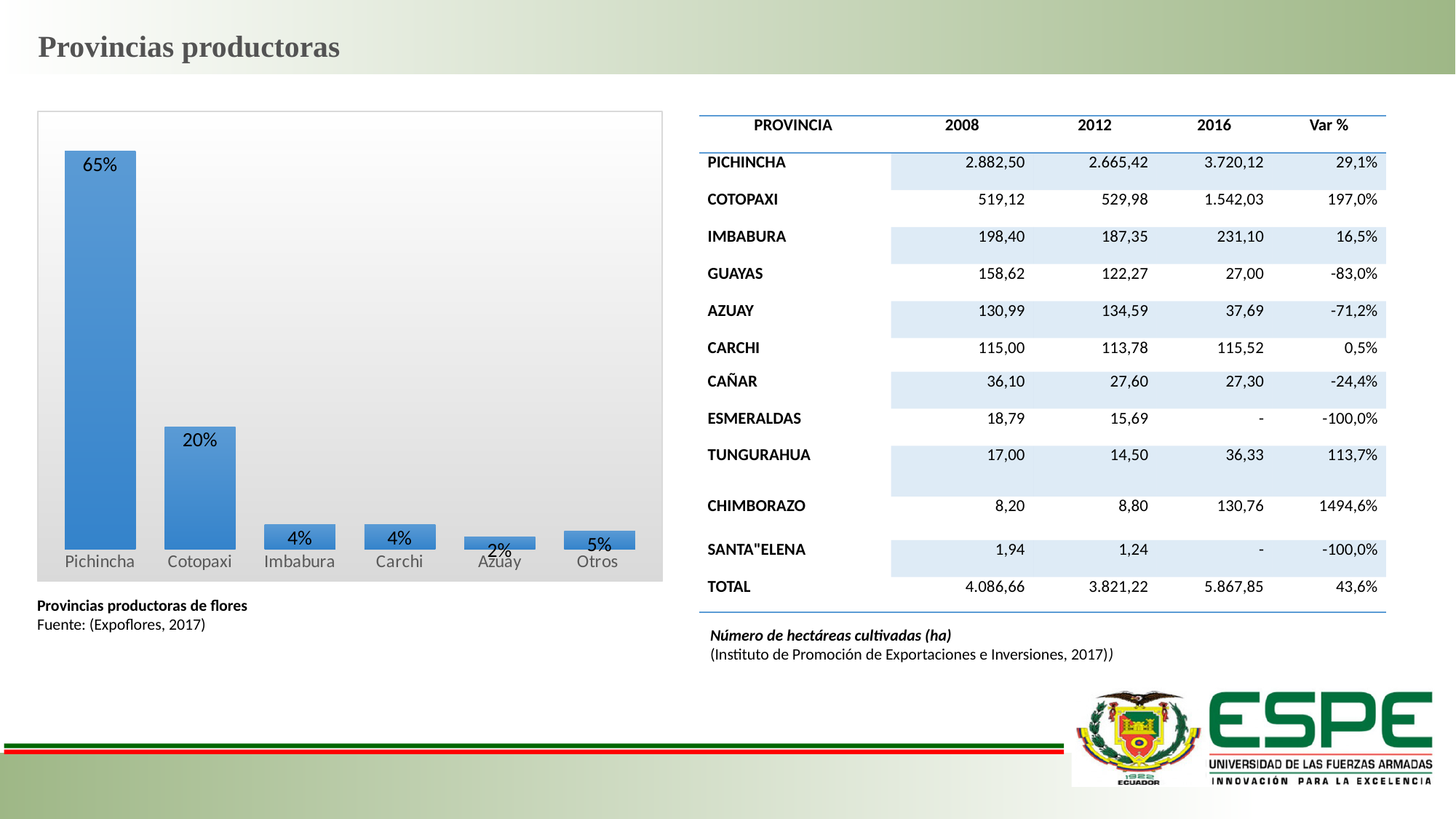
Which category has the lowest value in the bar chart? Azuay What is the value for Azuay in the bar chart? 2% How many categories are shown in the bar chart? 6 What is the caption given below the bar chart? Provincias productoras de flores What kind of chart is shown on the slide? Bar chart What is the value for Otros in the bar chart? 5% What is the value for Pichincha in the bar chart? 65% What is the value for Cotopaxi in the bar chart? 20% Which province has the highest value in the bar chart? Pichincha What source is cited for the bar chart? Expoflores, 2017 What is the difference between the values for Pichincha and Cotopaxi in the bar chart? 45%